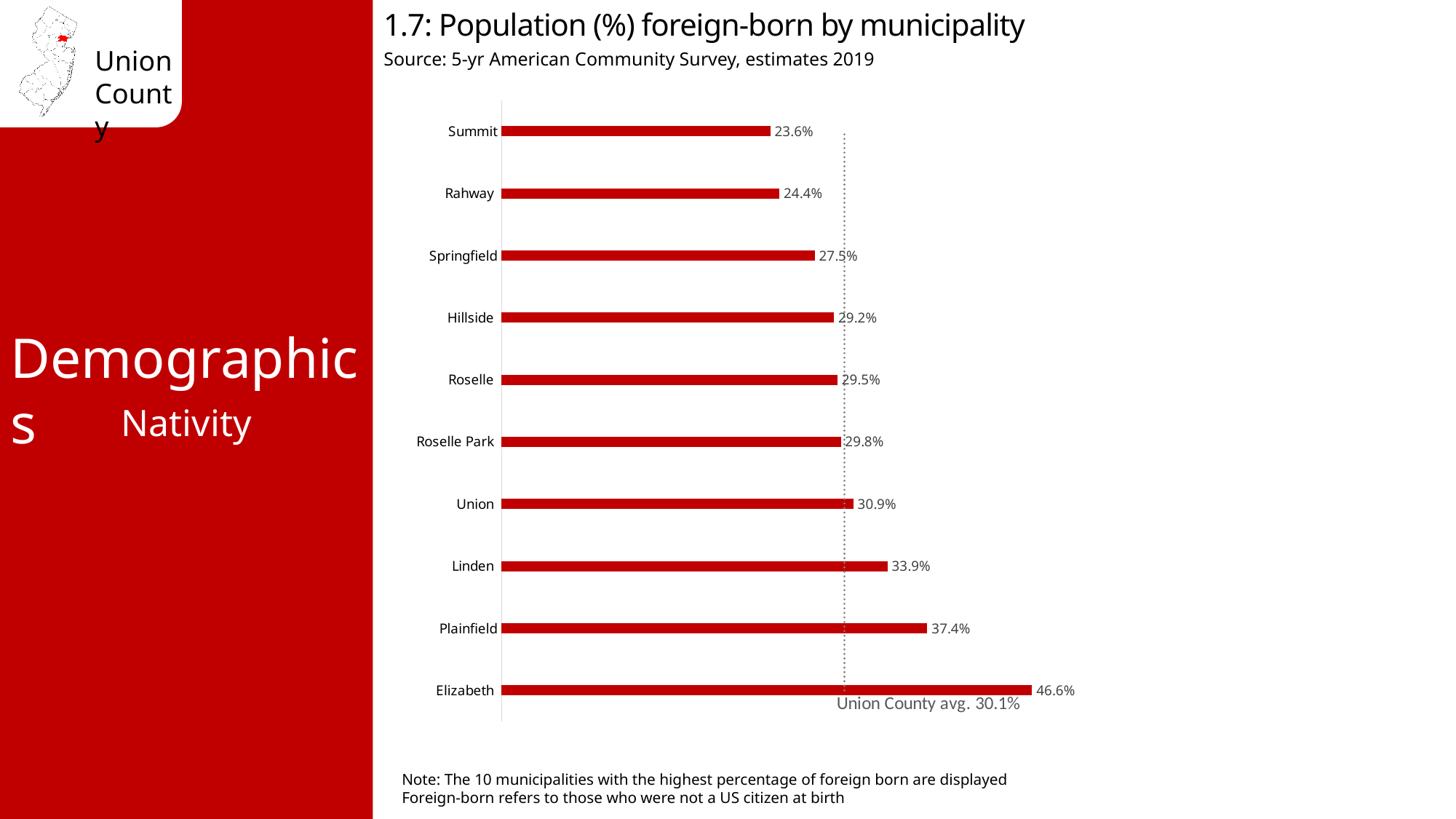
What is the Union County average foreign-born percentage shown by the dotted line? 30.1% How many municipalities are shown in the chart? 10 What is the source of the data shown in the chart? 5-yr American Community Survey, estimates 2019 What type of chart is used on this slide? Bar chart What is the percentage of foreign-born population in Linden? 33.9% Which municipality has the lowest percentage of foreign-born population? Summit What is the difference in foreign-born percentage between Rahway and Summit? 0.8% What is the difference in foreign-born percentage between Elizabeth and Plainfield? 9.2% Which municipality has the highest percentage of foreign-born population? Elizabeth Which has a higher foreign-born percentage, Union or Hillside? Union What is the percentage of foreign-born population in Elizabeth? 46.6% What is the percentage of foreign-born population in Summit? 23.6%